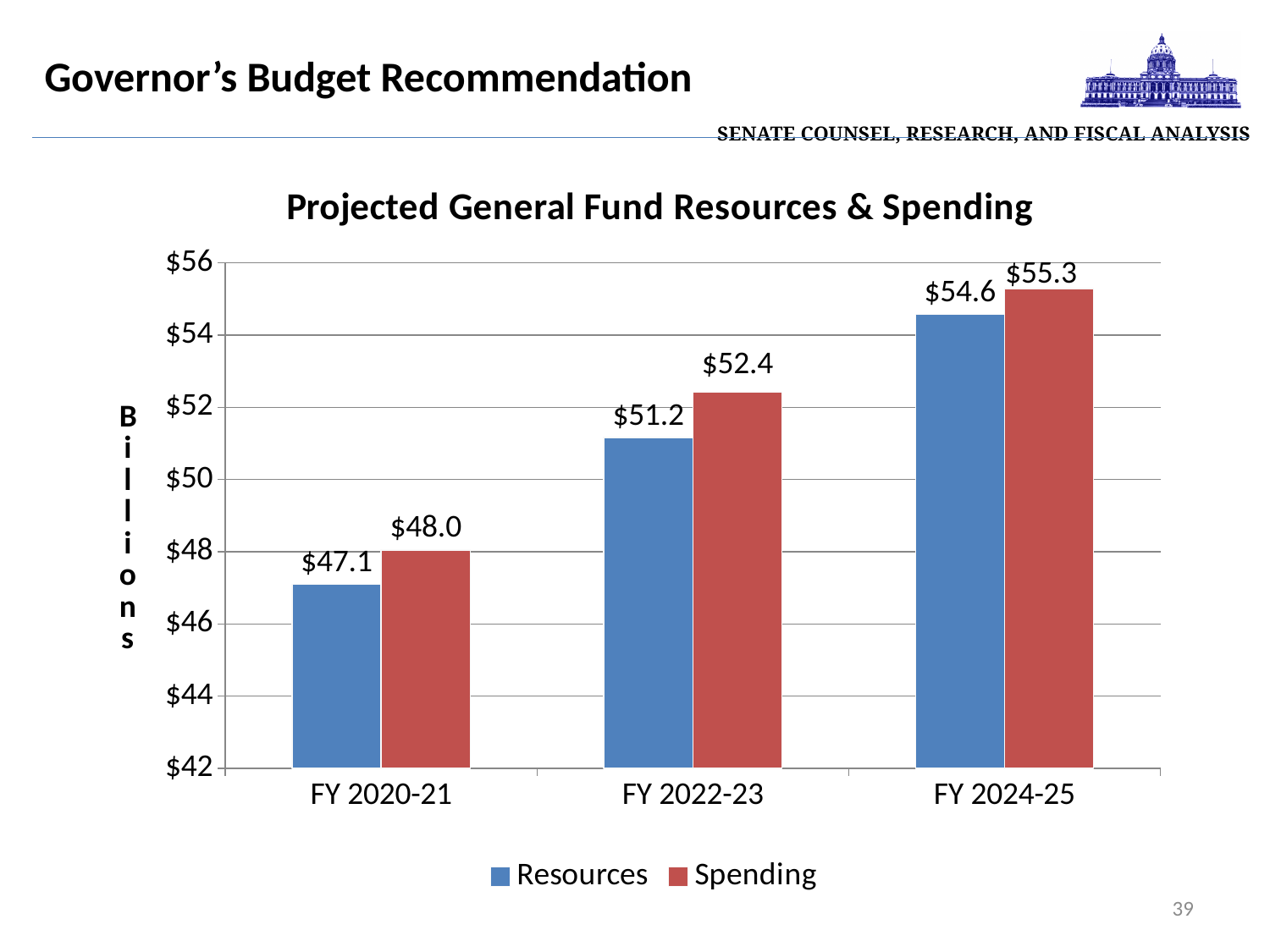
Which fiscal year has the highest Resources value? FY 2024-25 What is the Spending value for FY 2024-25? $55.3 Which fiscal year has the lowest Spending value? FY 2020-21 What is the Spending value for FY 2022-23? $52.4 What kind of chart is shown on the slide? Bar chart How many series does the legend list? 2 What is the difference between Spending and Resources in FY 2022-23? $1.2 In FY 2020-21, which is larger, Resources or Spending? Spending What is the difference between Spending and Resources in FY 2024-25? $0.7 How many fiscal years are shown on the x axis? 3 Do the Resources values rise or fall from FY 2020-21 to FY 2024-25? Rise What is the Resources value for FY 2020-21? $47.1